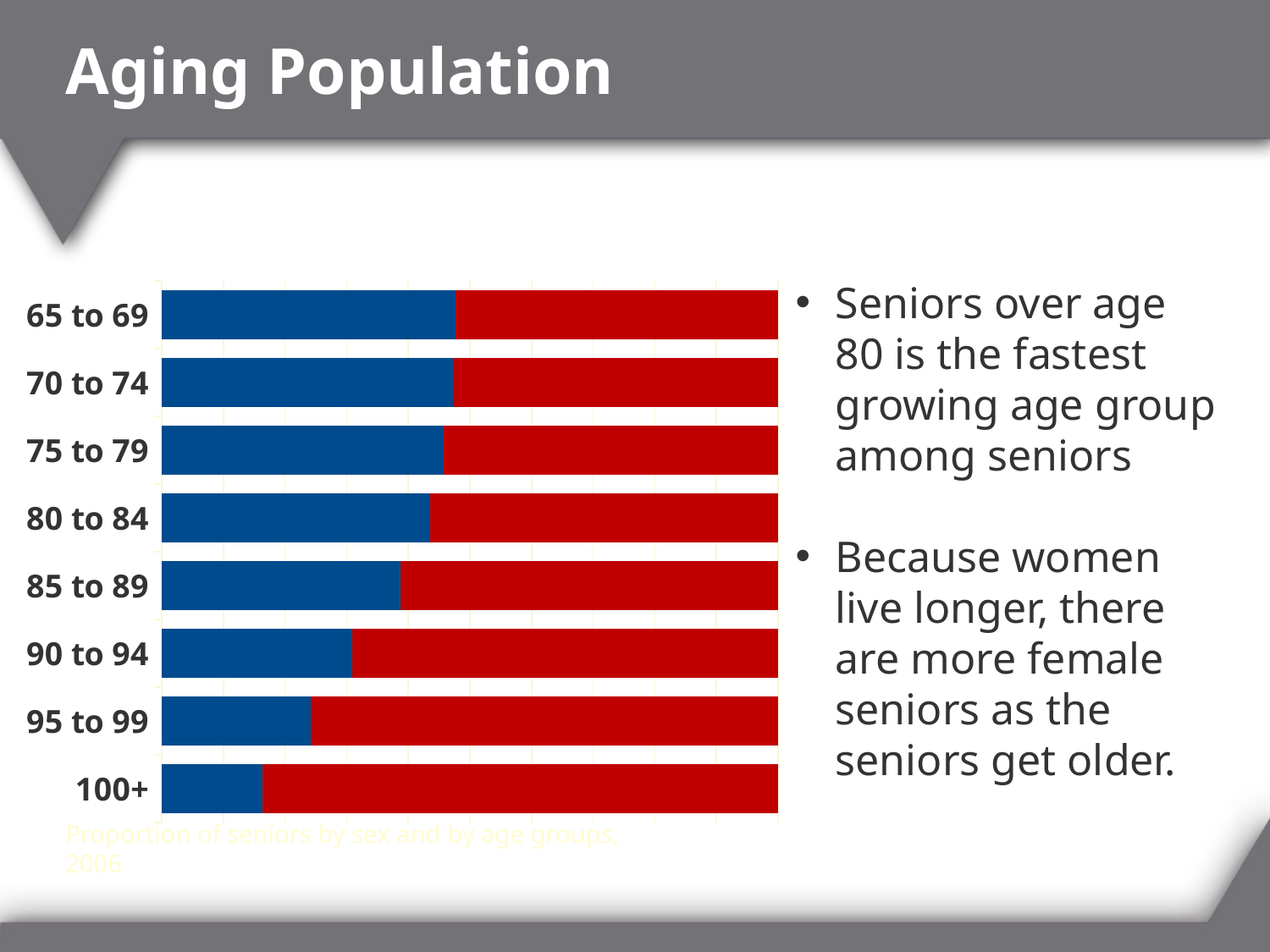
What kind of chart is shown on the slide? Stacked bar chart For the 90 to 94 age group, which segment is larger, the blue or the red? Red As the age groups get older from 65 to 69 down to 100+, does the blue segment get larger or smaller? Smaller Which age group has the smallest blue segment? 100+ Which age group is listed at the top of the chart? 65 to 69 As the age groups get older from 65 to 69 down to 100+, does the red segment get larger or smaller? Larger Which age group has the largest red segment? 100+ For the 100+ age group, which segment is larger, the blue or the red? Red Which age group has a larger red segment, 80 to 84 or 95 to 99? 95 to 99 How many age groups are shown on the chart? 8 Which age group is listed at the bottom of the chart? 100+